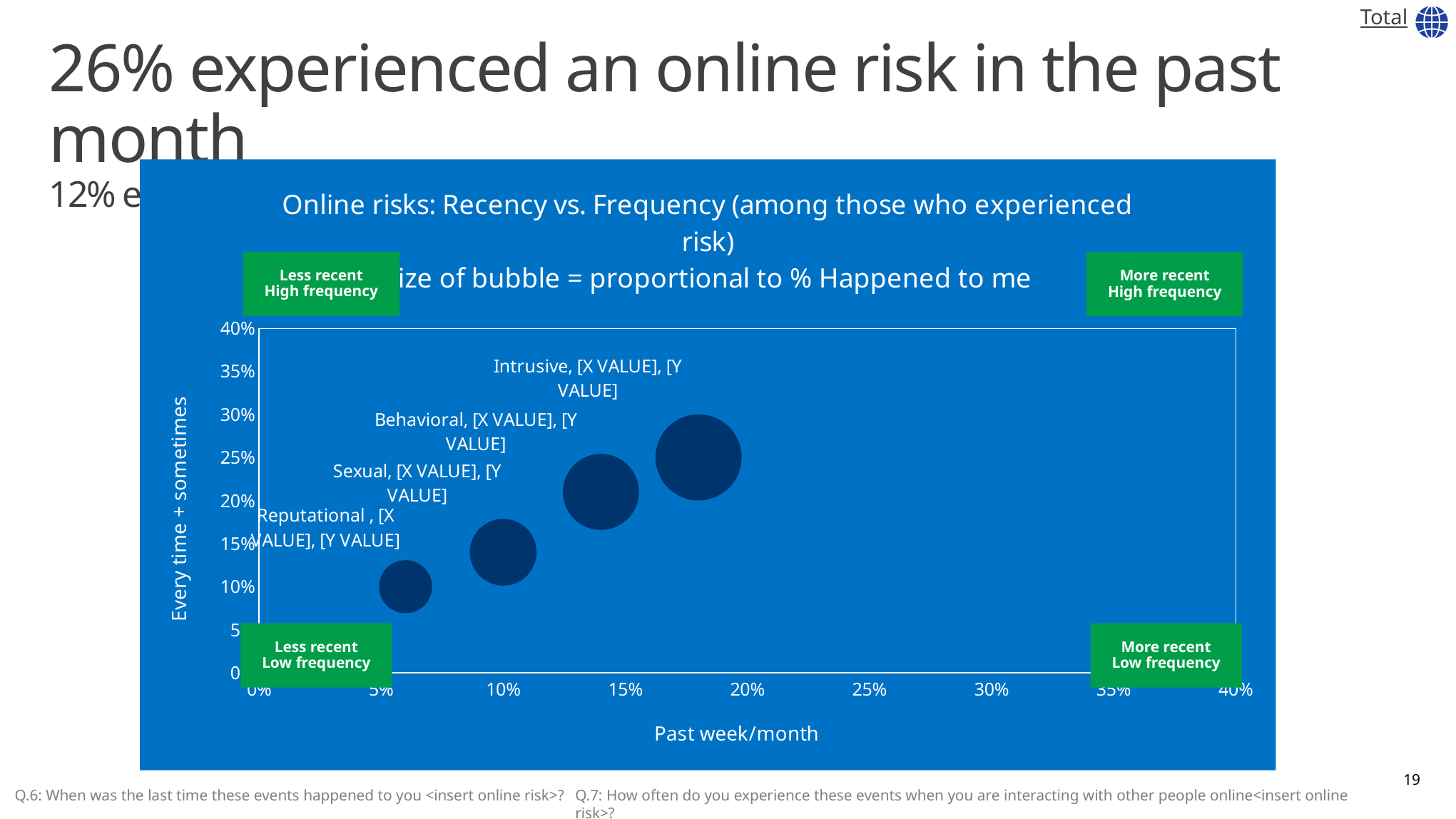
Is the 'Past week/month' value for Intrusive greater or less than 15%? greater Is the 'Every time + sometimes' value for Reputational greater or less than 15%? less Is the 'Every time + sometimes' value for Behavioral greater or less than 15%? greater How many bubbles (online risk categories) are plotted on the chart? 4 Which online risk has the highest value on the 'Every time + sometimes' axis? Intrusive What is the title of the chart? Online risks: Recency vs. Frequency (among those who experienced risk) As the 'Past week/month' value increases across the bubbles, does the 'Every time + sometimes' value rise or fall? Rise According to the chart subtitle, what is the size of each bubble proportional to? % Happened to me Which online risk has the lowest value on the 'Past week/month' axis? Reputational What kind of chart is shown on the slide? Bubble chart Which has a higher 'Every time + sometimes' value, Intrusive or Reputational? Intrusive